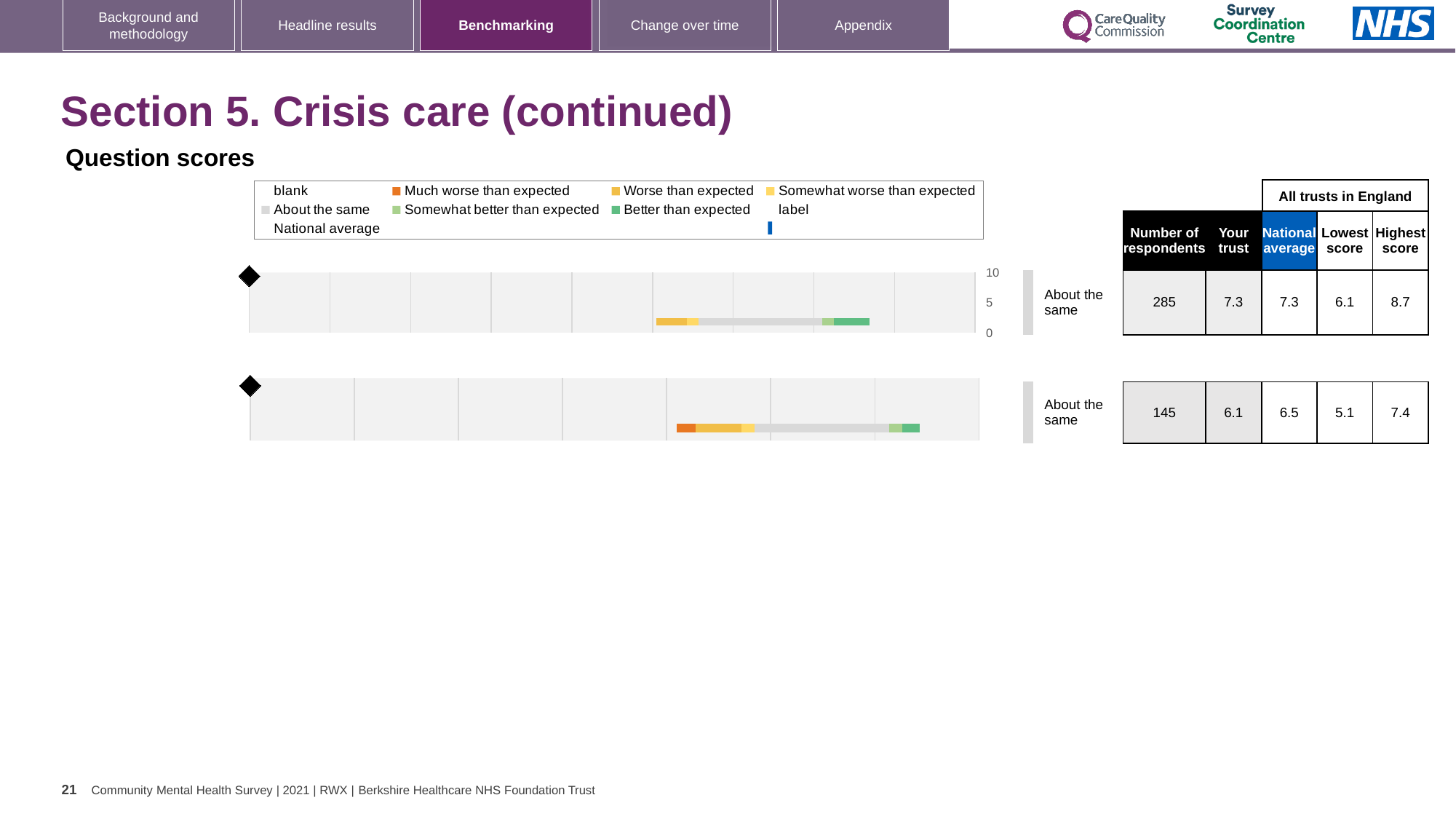
In the top chart's table, what is the highest score among all trusts in England? 8.7 What kind of chart is used on this slide? Bar chart In the bottom chart's table, what is the number of respondents? 145 In the top chart's table, what is the number of respondents? 285 Which chart has more respondents, the top chart or the bottom chart? Top chart In the top chart's table, what is the 'Your trust' score? 7.3 What benchmark category label is shown next to both the top and bottom charts? About the same In the top chart's table, what is the difference between the highest score and the lowest score? 2.6 In the bottom chart's table, what is the national average score? 6.5 In the bottom chart's table, what is the lowest score among all trusts in England? 5.1 In the bottom chart's table, which is larger: the 'Your trust' score or the national average? National average In the bottom chart's table, what is the difference between the national average and the 'Your trust' score? 0.4